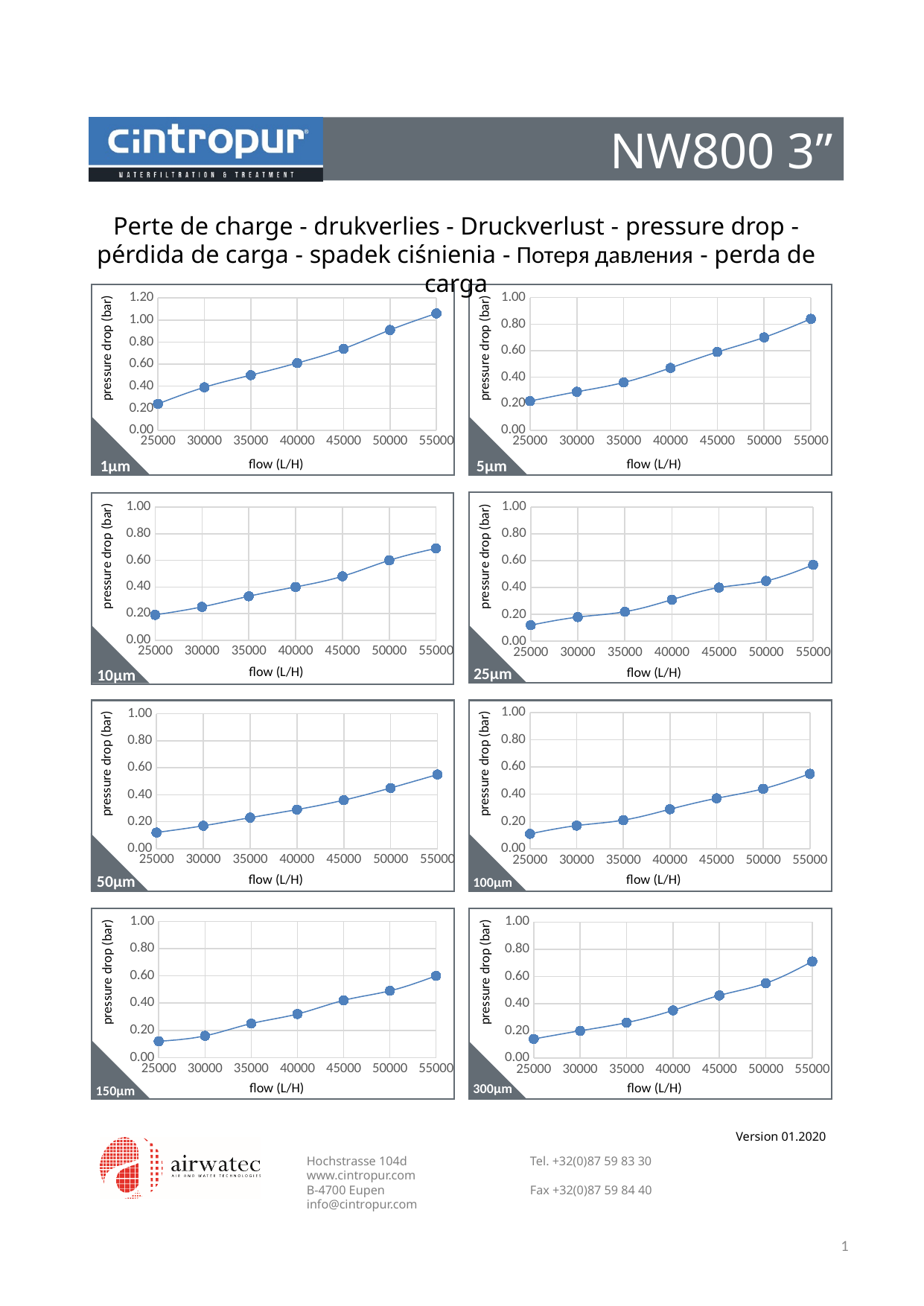
How many data points are plotted on the 1µm chart? 7 On the 150µm chart, is the pressure drop at 40000 L/H greater or less than 0.40 bar? less How many charts are shown on the slide? 8 What kind of chart is the 1µm chart? line chart On the 5µm chart, is the pressure drop at 25000 L/H greater or less than 0.40 bar? less On the 300µm chart, is the pressure drop at 55000 L/H greater or less than 0.60 bar? greater What is the x-axis label on the 50µm chart? flow (L/H) On the 5µm chart, does the pressure drop rise or fall as flow increases? rise On the 10µm chart, at which flow is the pressure drop highest? 55000 On the 25µm chart, at which flow is the pressure drop lowest? 25000 On the 1µm chart, which flow has the larger pressure drop, 30000 or 50000 L/H? 50000